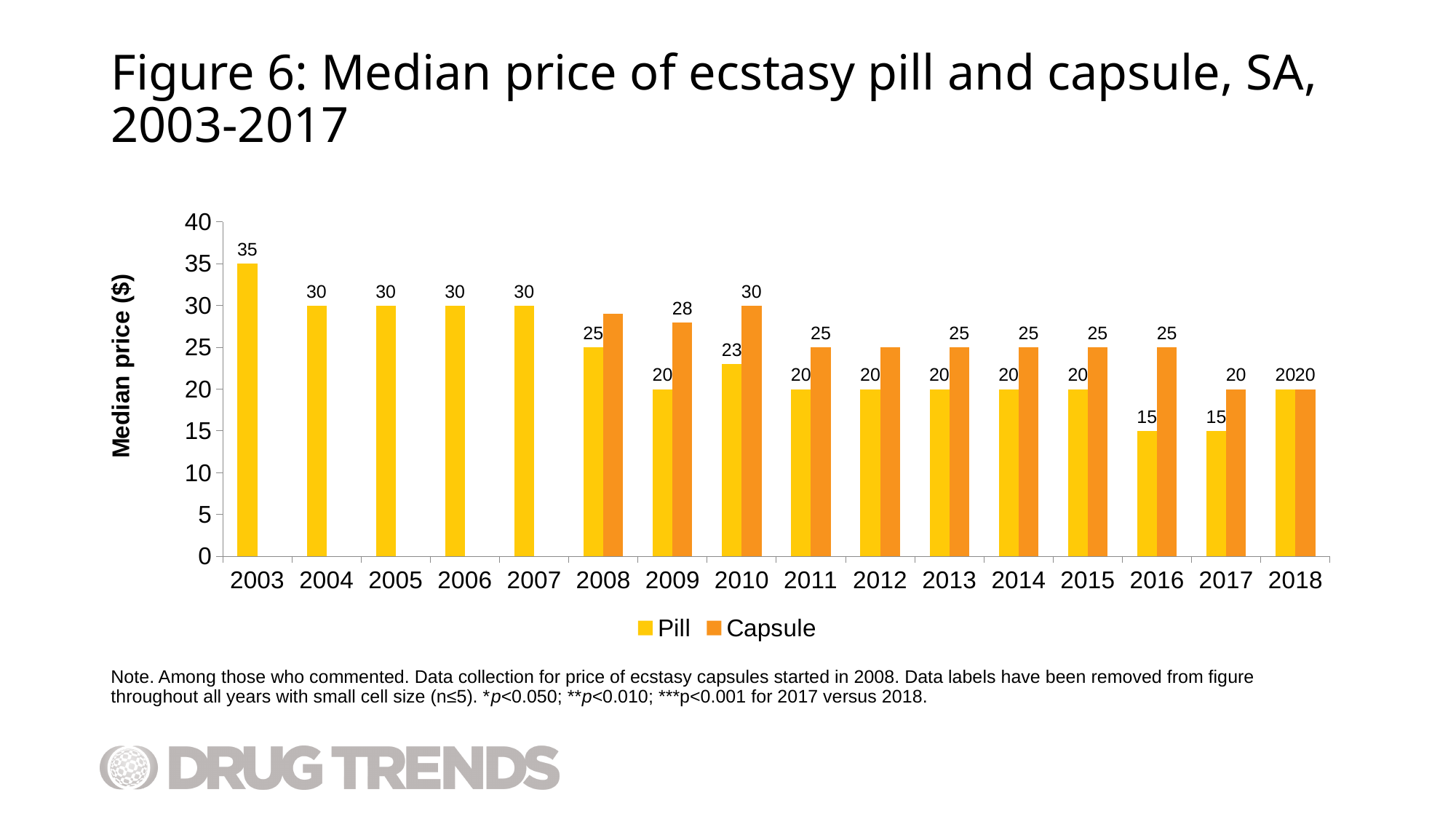
In which year is the median pill price highest? 2003 What is the median price of an ecstasy capsule in 2009? 28 Is the median capsule price in 2008 greater or less than 25? greater What is the median price of an ecstasy pill in 2003? 35 What is the median price of an ecstasy pill in 2010? 23 What is the difference between the median pill price in 2003 and in 2018? 15 How many series does the legend list? 2 In 2010, which has the higher median price, Pill or Capsule? Capsule What kind of chart is shown? bar chart What is the difference between the capsule and pill median prices in 2016? 10 How many years are shown on the x axis? 16 What is the median price of an ecstasy capsule in 2017? 20